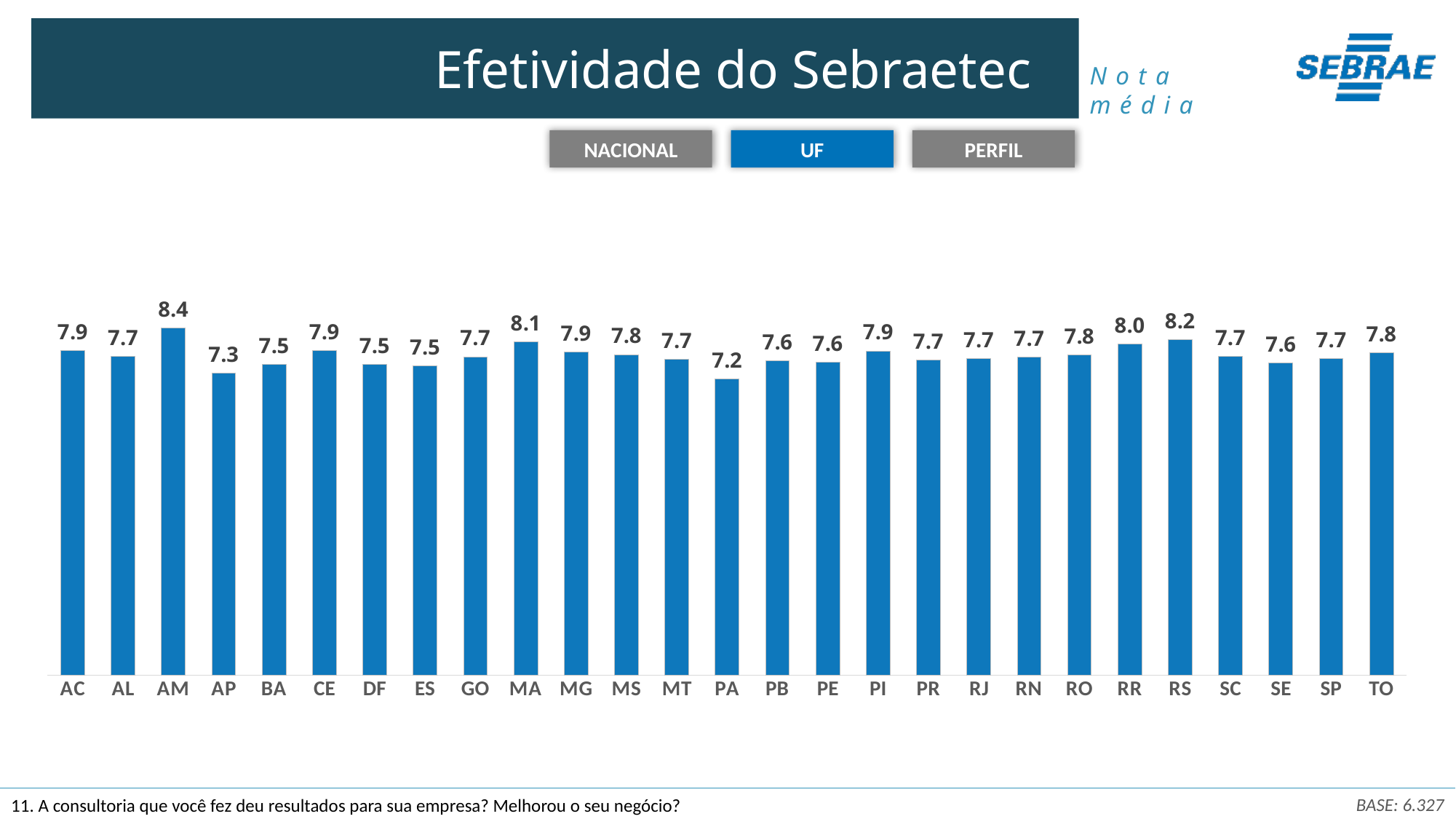
What is the value for PA? 7.2 How many states are shown on the x axis? 27 Which state has the lowest value? PA What is the title of the slide? Efetividade do Sebraetec What is the value for AM? 8.4 What is the value for RS? 8.2 What is the difference between the values for AM and PA? 1.2 What kind of chart is shown on the slide? Bar chart Which state has the highest value? AM Which has a larger value, MA or RR? MA What is the value for SP? 7.7 What is the difference between the values for RS and AP? 0.9